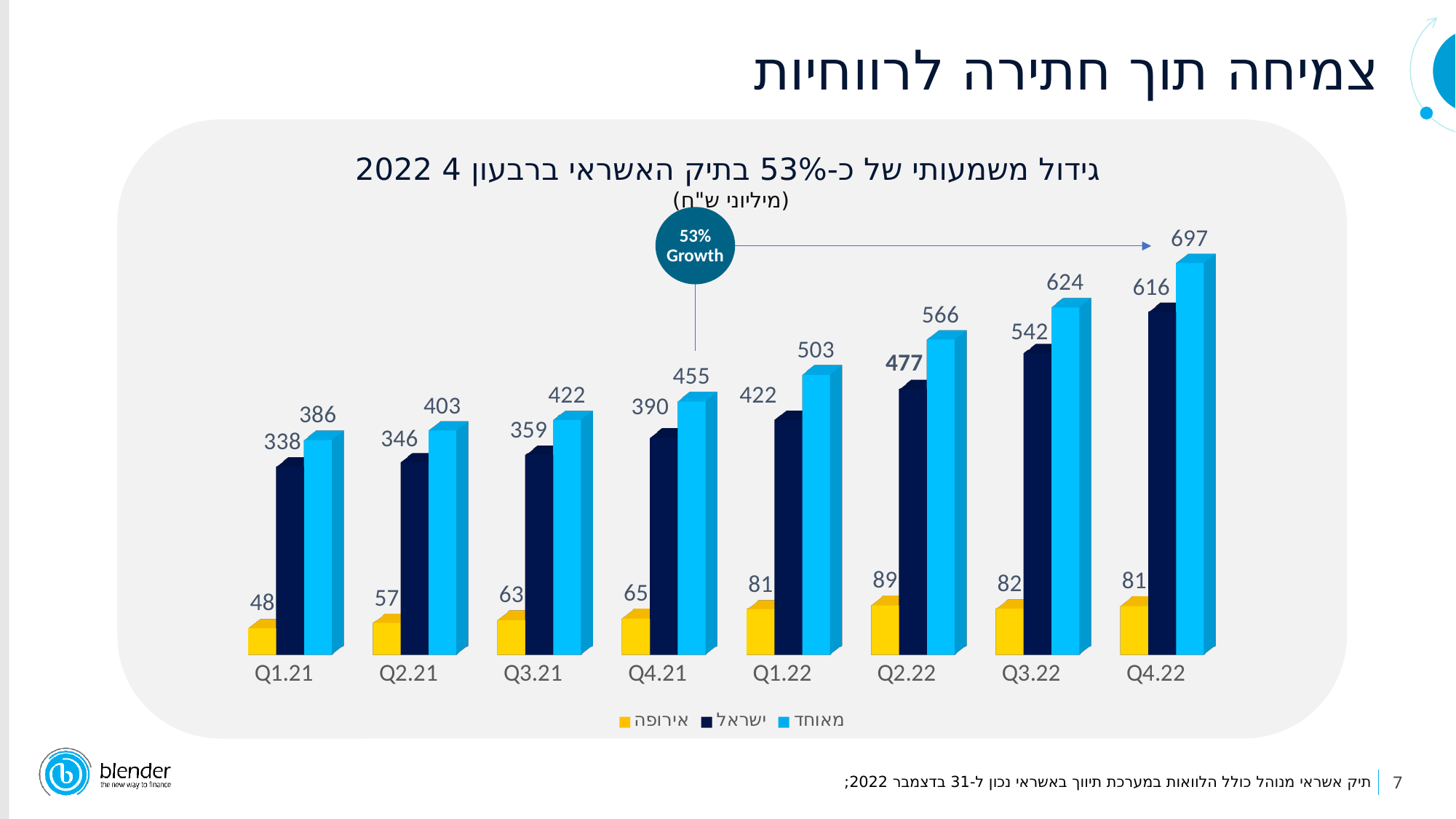
In which quarter is the מאוחד (consolidated) series lowest? Q1.21 In which quarter is the אירופה (Europe) series highest? Q2.22 What is the value of the אירופה (Europe) series for Q1.21? 48 What kind of chart is shown on the slide? Bar chart What is the value of the מאוחד (consolidated) series for Q4.22? 697 How many series does the legend list? 3 What is the value of the ישראל (Israel) series for Q2.22? 477 What is the difference between the מאוחד (consolidated) values for Q4.22 and Q4.21? 242 Does the מאוחד (consolidated) series rise or fall from Q1.21 to Q4.22? Rise What growth percentage is shown in the circle callout above the chart? 53% Growth Which is larger: the ישראל (Israel) value for Q3.22 or the מאוחד (consolidated) value for Q1.22? ישראל (Israel) for Q3.22 How many quarters are shown on the x axis? 8